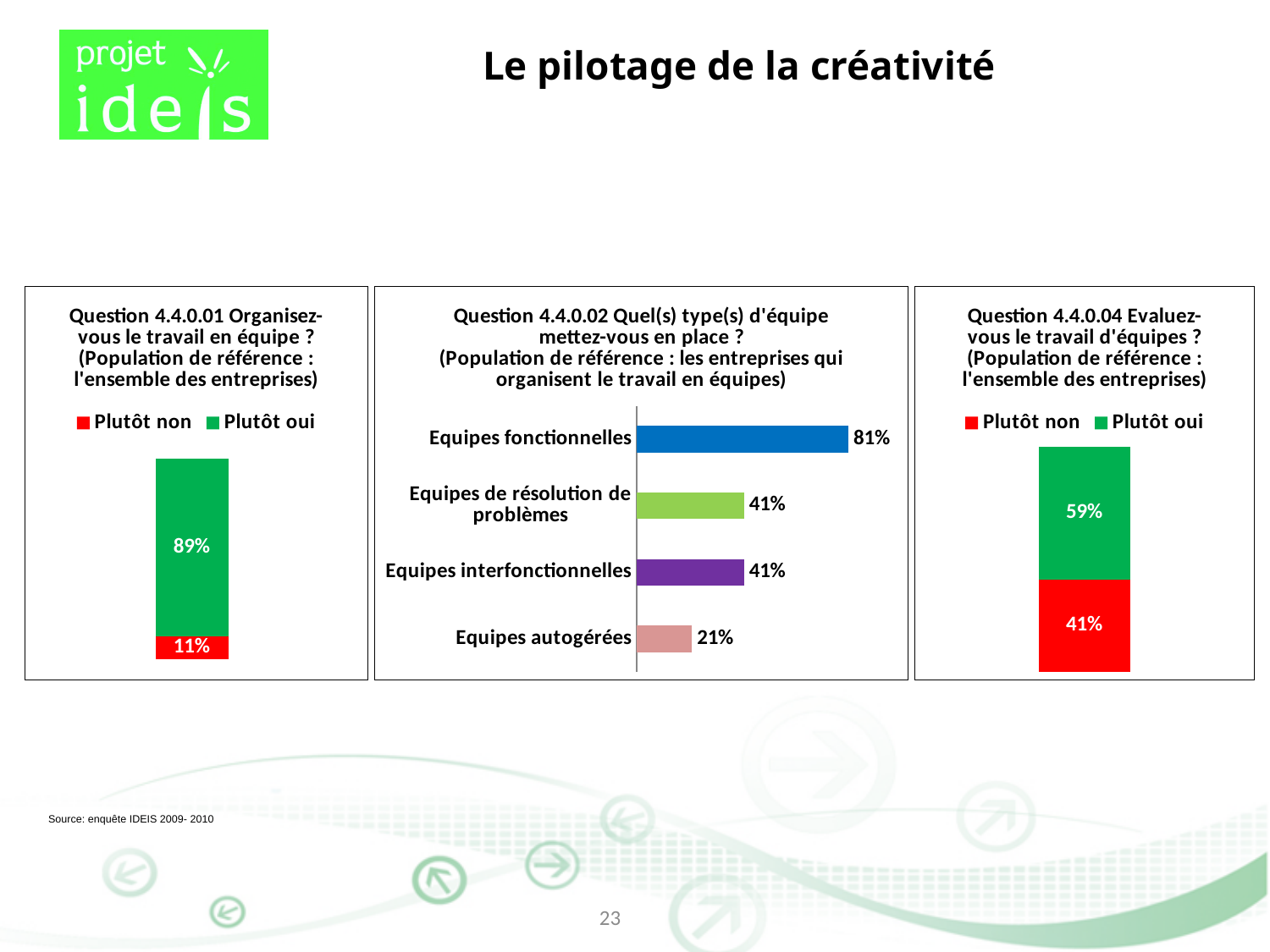
In the left chart (Question 4.4.0.01), what is the value for Plutôt non? 11% In the middle chart (Question 4.4.0.02), which category has the highest value? Equipes fonctionnelles In the right chart (Question 4.4.0.04 Evaluez-vous le travail d'équipes ?), what is the value for Plutôt non? 41% What kind of chart is the middle chart (Question 4.4.0.02)? Bar chart In the left chart (Question 4.4.0.01), what is the difference between Plutôt oui and Plutôt non? 78% In the left chart (Question 4.4.0.01 Organisez-vous le travail en équipe ?), what is the value for Plutôt oui? 89% In the middle chart (Question 4.4.0.02), what is the value for Equipes autogérées? 21% In the middle chart (Question 4.4.0.02), how many categories are shown? 4 In the right chart (Question 4.4.0.04), which is larger, Plutôt oui or Plutôt non? Plutôt oui In the middle chart (Question 4.4.0.02), which category has the lowest value? Equipes autogérées In the middle chart (Question 4.4.0.02 Quel(s) type(s) d'équipe mettez-vous en place ?), what is the value for Equipes fonctionnelles? 81% In the middle chart (Question 4.4.0.02), what is the difference between Equipes fonctionnelles and Equipes interfonctionnelles? 40%